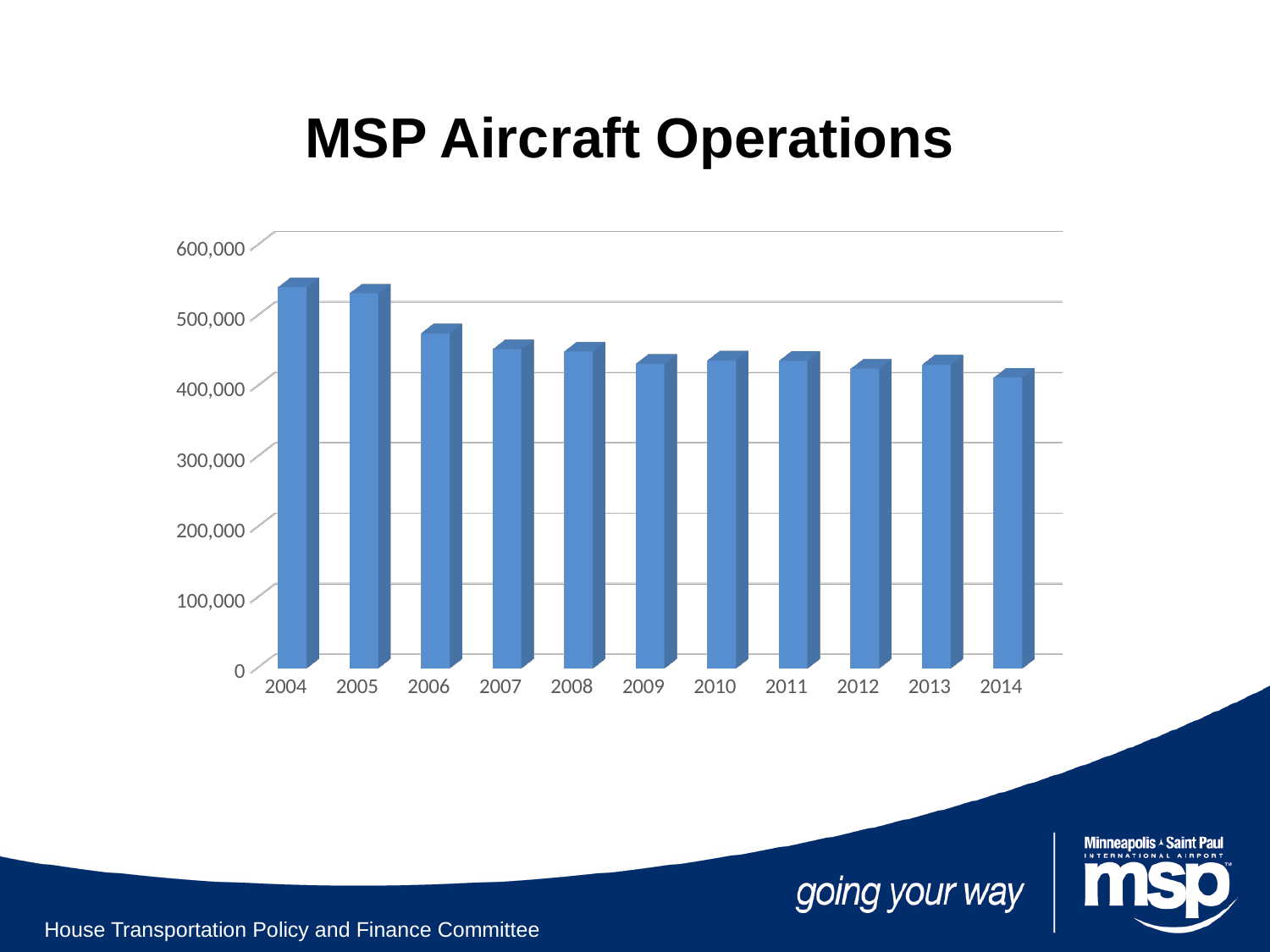
Is the value for 2014 greater or less than 500,000? less Which year has more aircraft operations, 2004 or 2014? 2004 Is the value for 2006 greater or less than 500,000? less What kind of chart is shown on the slide? bar chart Which year has the lowest number of aircraft operations? 2014 What is the title of the chart? MSP Aircraft Operations Do aircraft operations generally rise or fall from 2004 to 2014? fall Which year has the highest number of aircraft operations? 2004 Is the value for 2004 greater or less than 500,000? greater Which year has more aircraft operations, 2006 or 2012? 2006 How many years are shown on the x axis of the chart? 11